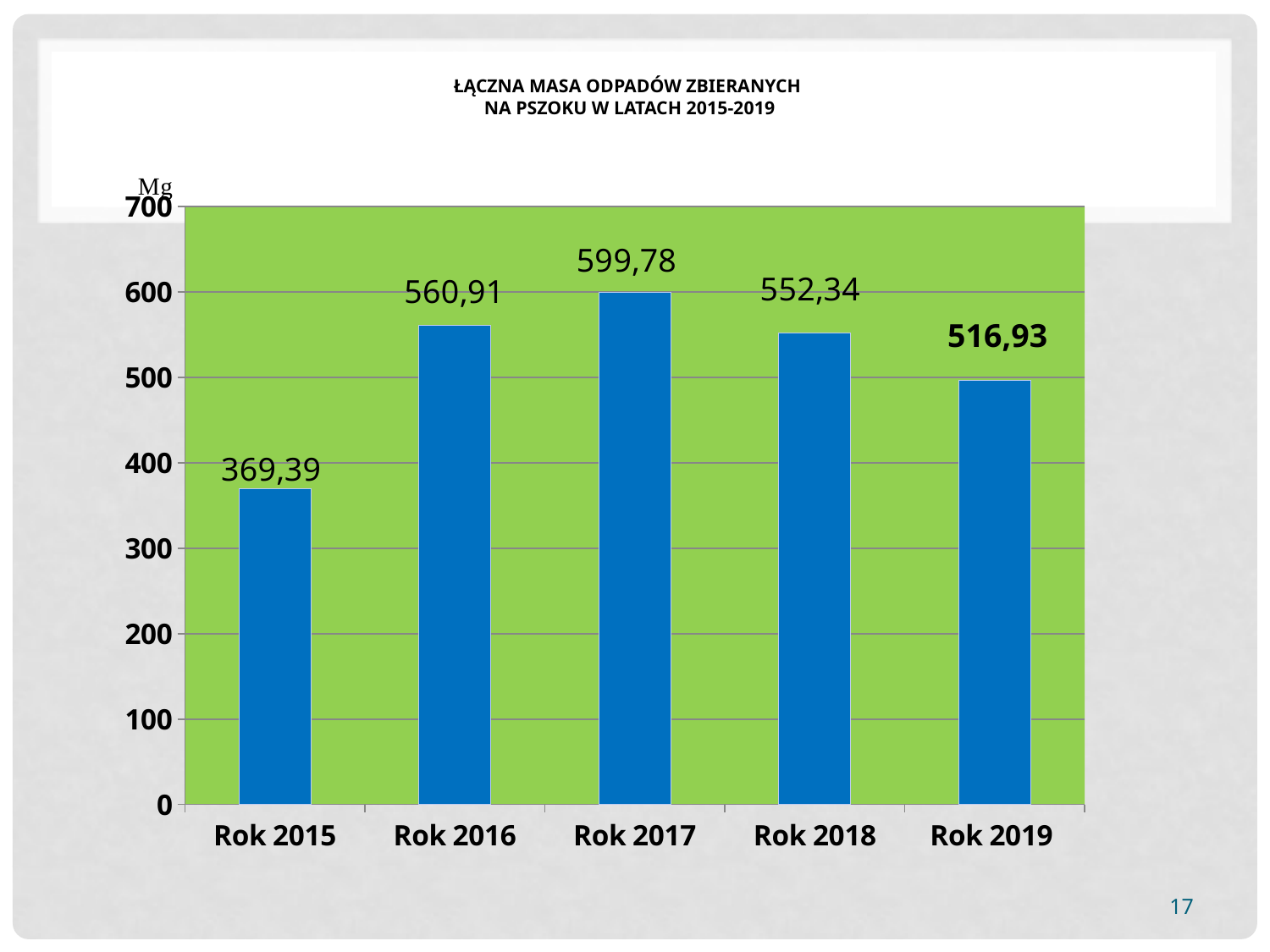
Which year has the highest value? Rok 2017 Which year has the lowest value? Rok 2015 What is the value for Rok 2015? 369,39 Which is larger, the value for Rok 2016 or the value for Rok 2018? Rok 2016 Do the values rise or fall from Rok 2017 to Rok 2019? fall Is the value for Rok 2015 greater or less than 400? less What is the difference between the values for Rok 2017 and Rok 2015? 230,39 What kind of chart is shown on the slide? bar chart What is the value for Rok 2017? 599,78 What is the value labelled for Rok 2019? 516,93 What is the difference between the values for Rok 2017 and Rok 2018? 47,44 How many years are shown on the x axis? 5